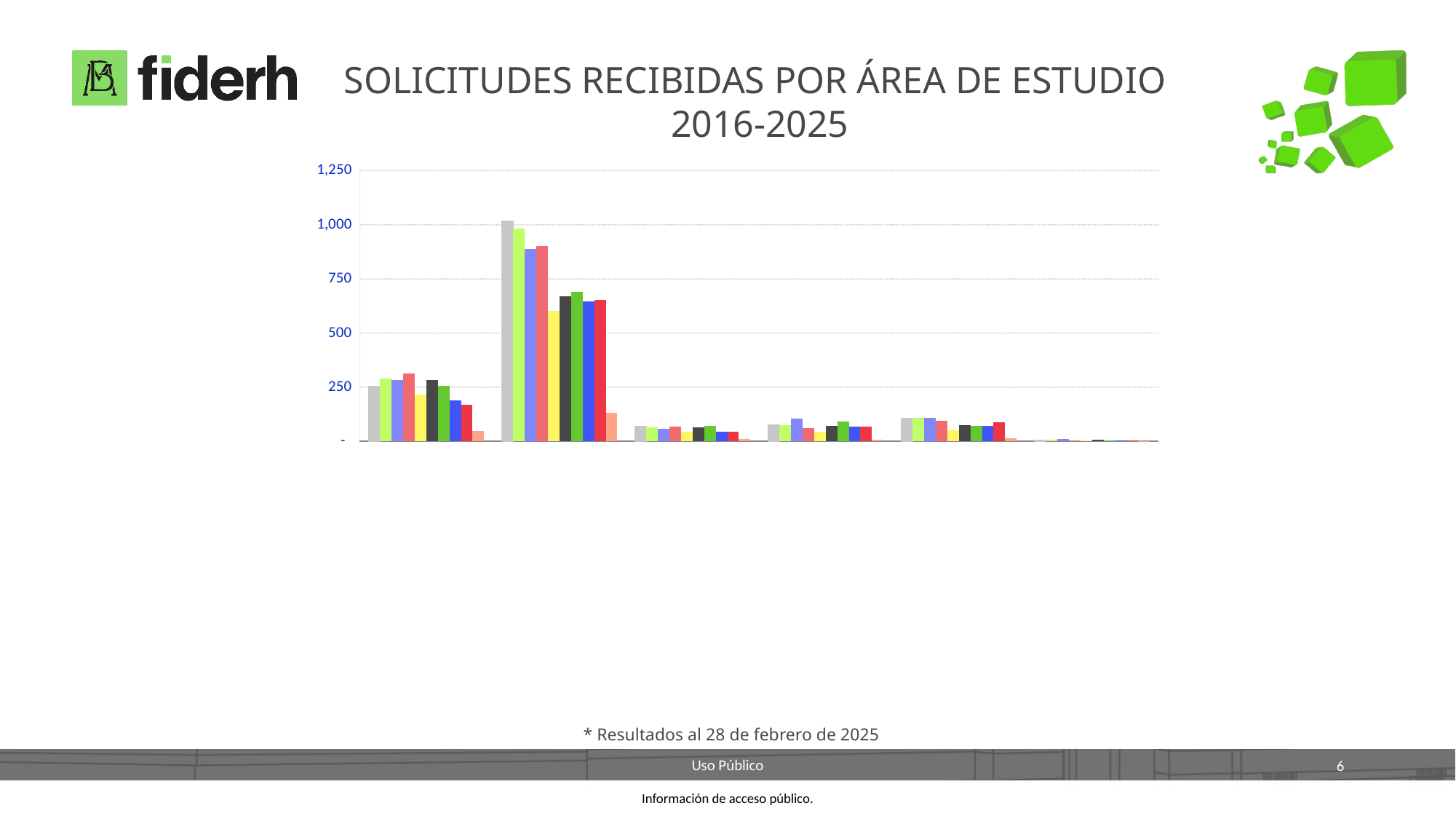
What is the title of the chart on the slide? SOLICITUDES RECIBIDAS POR ÁREA DE ESTUDIO 2016-2025 Which group of bars contains the tallest bar in the chart, the first or the second? the second What is the highest value shown on the vertical axis of the chart? 1,250 Is the tallest bar in the chart greater or less than 750? greater Are all bars in the third group of bars greater or less than 250? less Is the tallest bar in the first group of bars greater or less than 500? less How many groups of bars are plotted in the chart? 6 What kind of chart is shown on the slide? bar chart